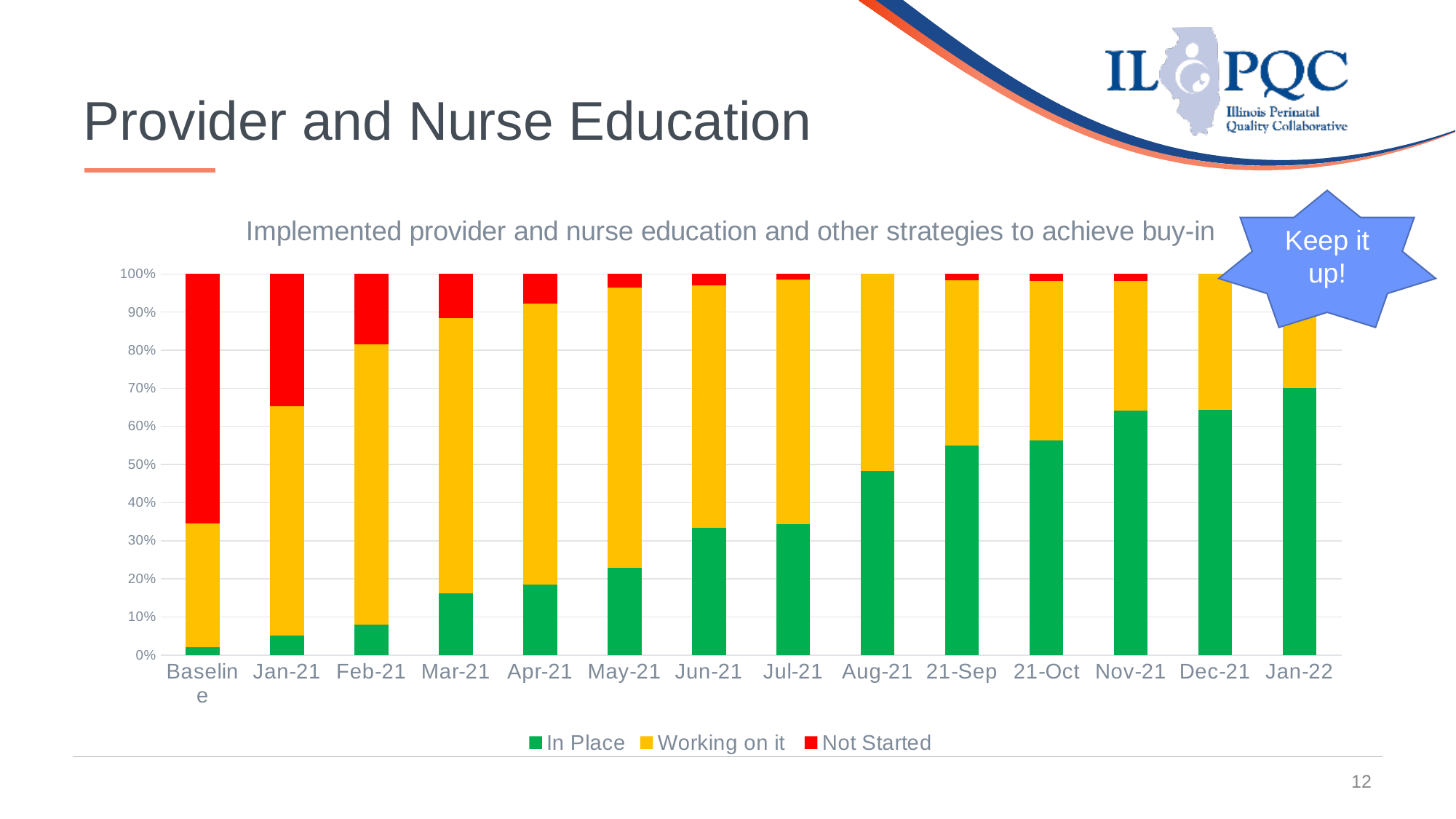
How many series does the legend list? 3 Which category has the highest 'Not Started' value? Baseline How many categories are shown along the x axis? 14 Is the 'In Place' value for Baseline greater or less than 10%? less Is the 'In Place' value for Nov-21 greater or less than 60%? greater Does the 'In Place' share rise or fall from Baseline to Jan-22? Rise Is the 'Not Started' value for Baseline greater or less than 60%? greater What kind of chart is shown on the slide? Stacked bar chart Which category has the highest 'In Place' value? Jan-22 What is the title of the chart? Implemented provider and nurse education and other strategies to achieve buy-in Which is larger, the 'In Place' value for Baseline or for Jan-22? Jan-22 What colour represents the 'In Place' series? Green